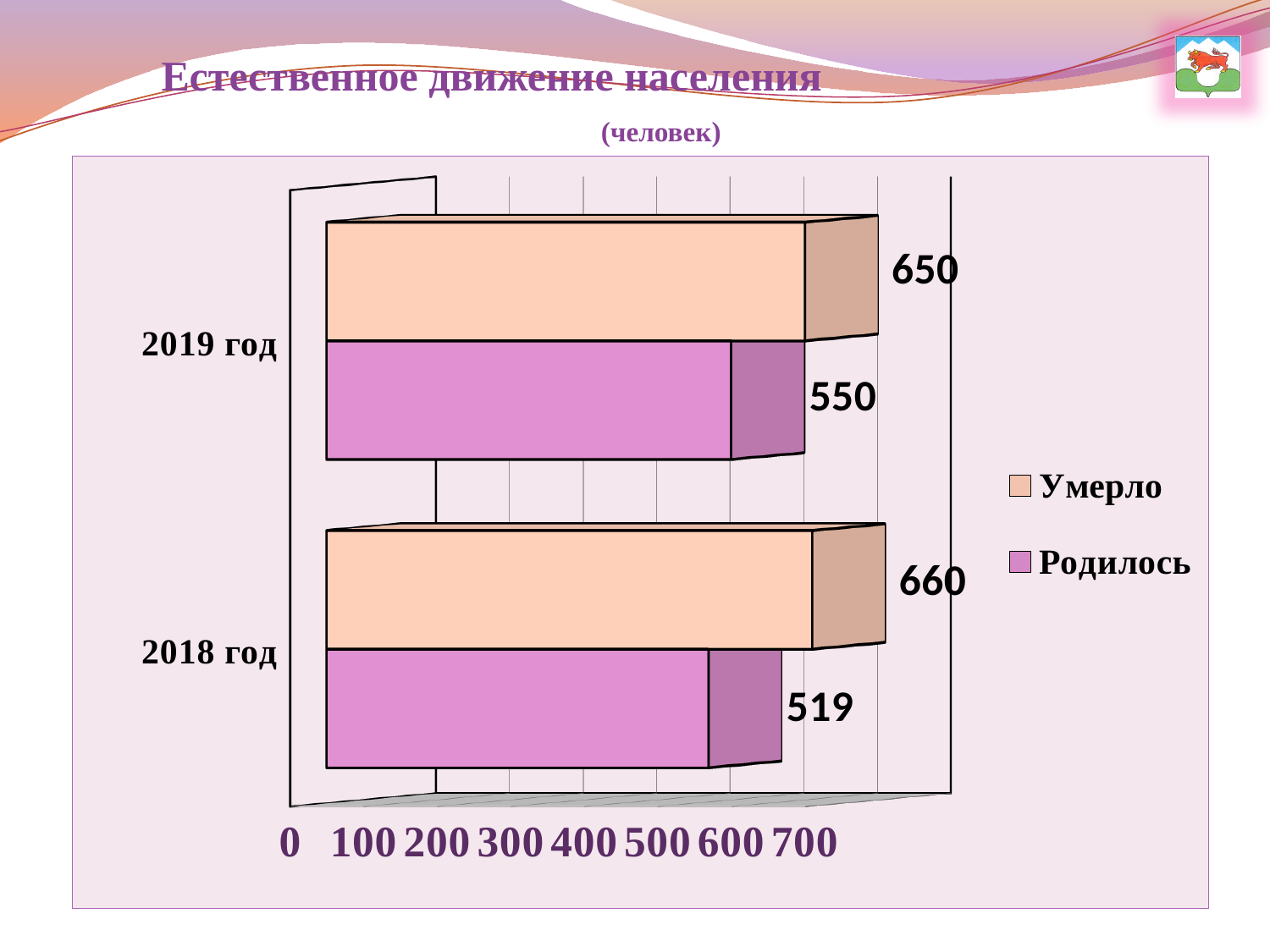
What is the difference between Умерло and Родилось in 2018 год? 141 What is the value for Родилось in 2019 год? 550 What is the value for Умерло in 2019 год? 650 What is the value for Родилось in 2018 год? 519 How many series does the legend list? 2 How many years are shown on the chart? 2 What is the title of the chart? Естественное движение населения Which year has the higher value for Родилось? 2019 год What kind of chart is shown on the slide? Bar chart What is the difference between Умерло and Родилось in 2019 год? 100 What is the value for Умерло in 2018 год? 660 Which year has the higher value for Умерло? 2018 год